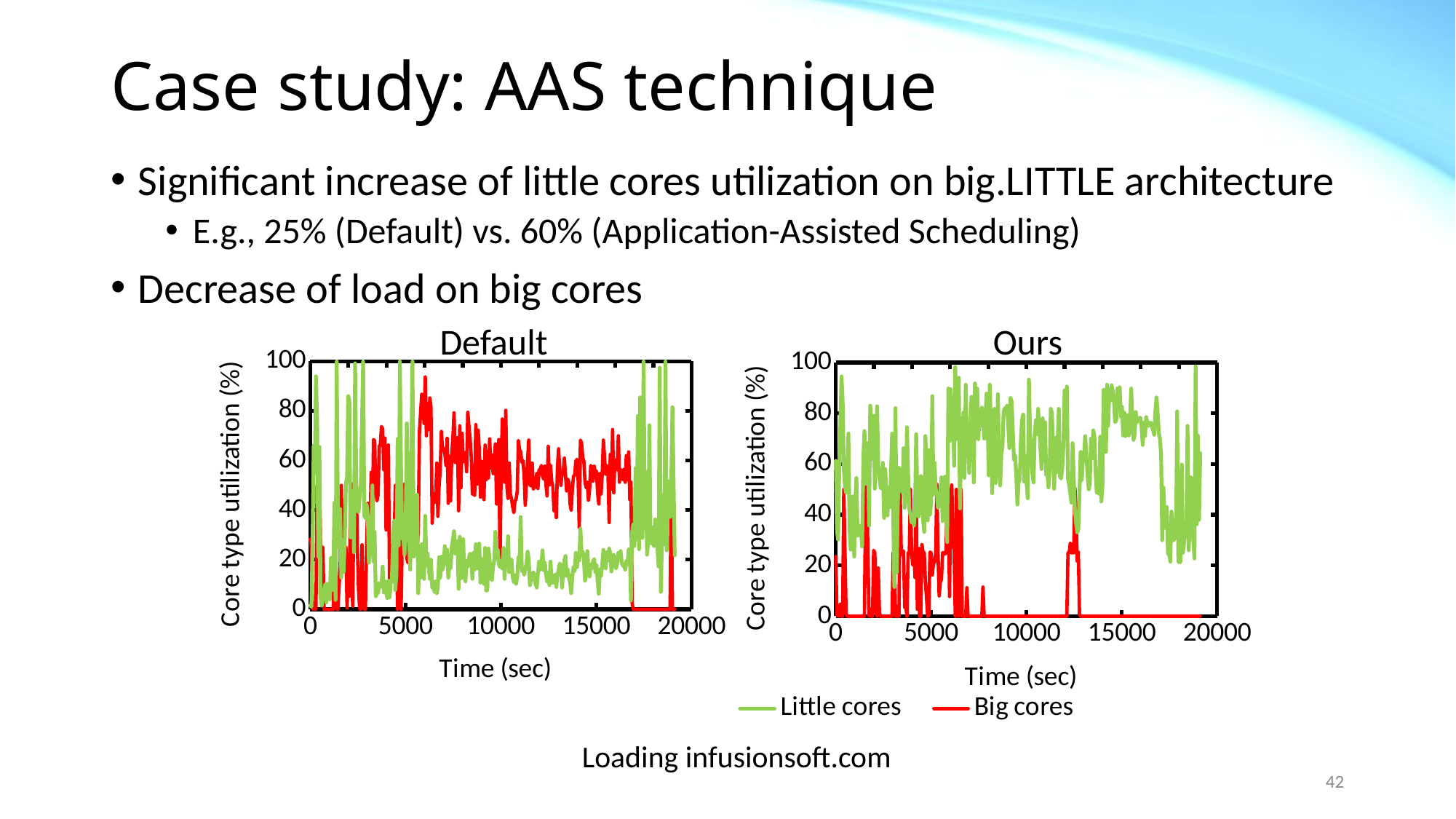
In the "Default" chart, which series is higher at around 10000 sec, Little cores or Big cores? Big cores In the "Ours" chart, which series is higher at around 15000 sec, Little cores or Big cores? Little cores In the "Ours" chart, is the Big cores value at around 10000 sec greater or less than 20? less In the "Ours" chart, is the Little cores value at around 10000 sec greater or less than 40? greater In the "Default" chart, is the Little cores value at around 10000 sec greater or less than 40? less What is the y-axis label on the "Ours" chart? Core type utilization (%) What are the two series named in the legend? Little cores, Big cores What kind of chart is the "Ours" chart? line chart How many series does the shared legend list for the charts? 2 What kind of chart is the "Default" chart? line chart